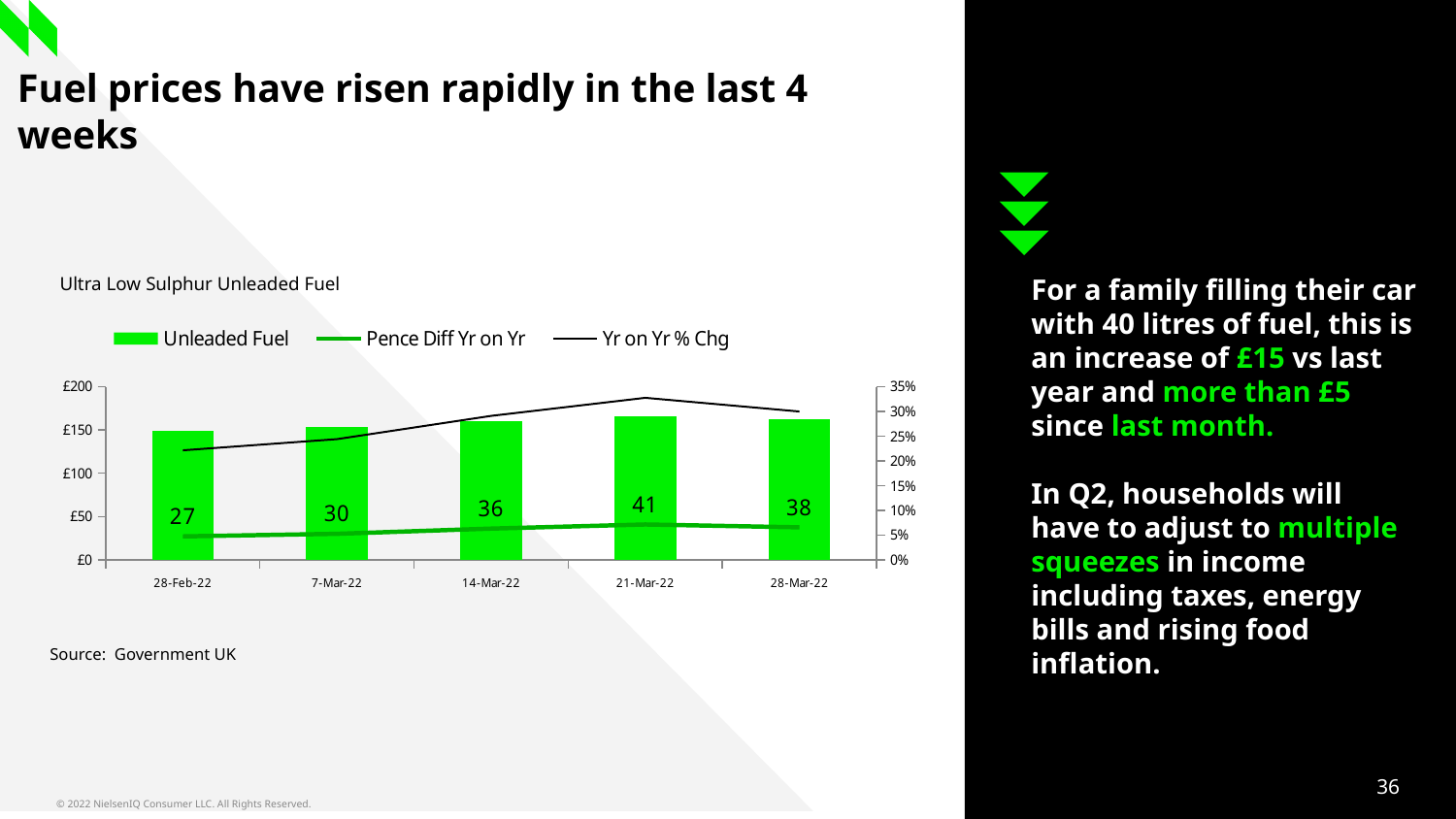
What is the difference between the data labels printed at 21-Mar-22 and 28-Feb-22? 14 Which date has the larger printed data label, 7-Mar-22 or 14-Mar-22? 14-Mar-22 Which date has the lowest printed data label? 28-Feb-22 What data label is printed at 28-Mar-22? 38 How many series does the chart legend list? 3 What data label is printed at 21-Mar-22? 41 What is the title of the chart? Ultra Low Sulphur Unleaded Fuel How many dates are shown on the x axis of the chart? 5 Is the Yr on Yr % Chg value for 28-Feb-22 greater or less than 25%? less Is the Unleaded Fuel bar for 21-Mar-22 greater or less than £150? greater Which date has the highest printed data label? 21-Mar-22 What data label is printed at 28-Feb-22? 27